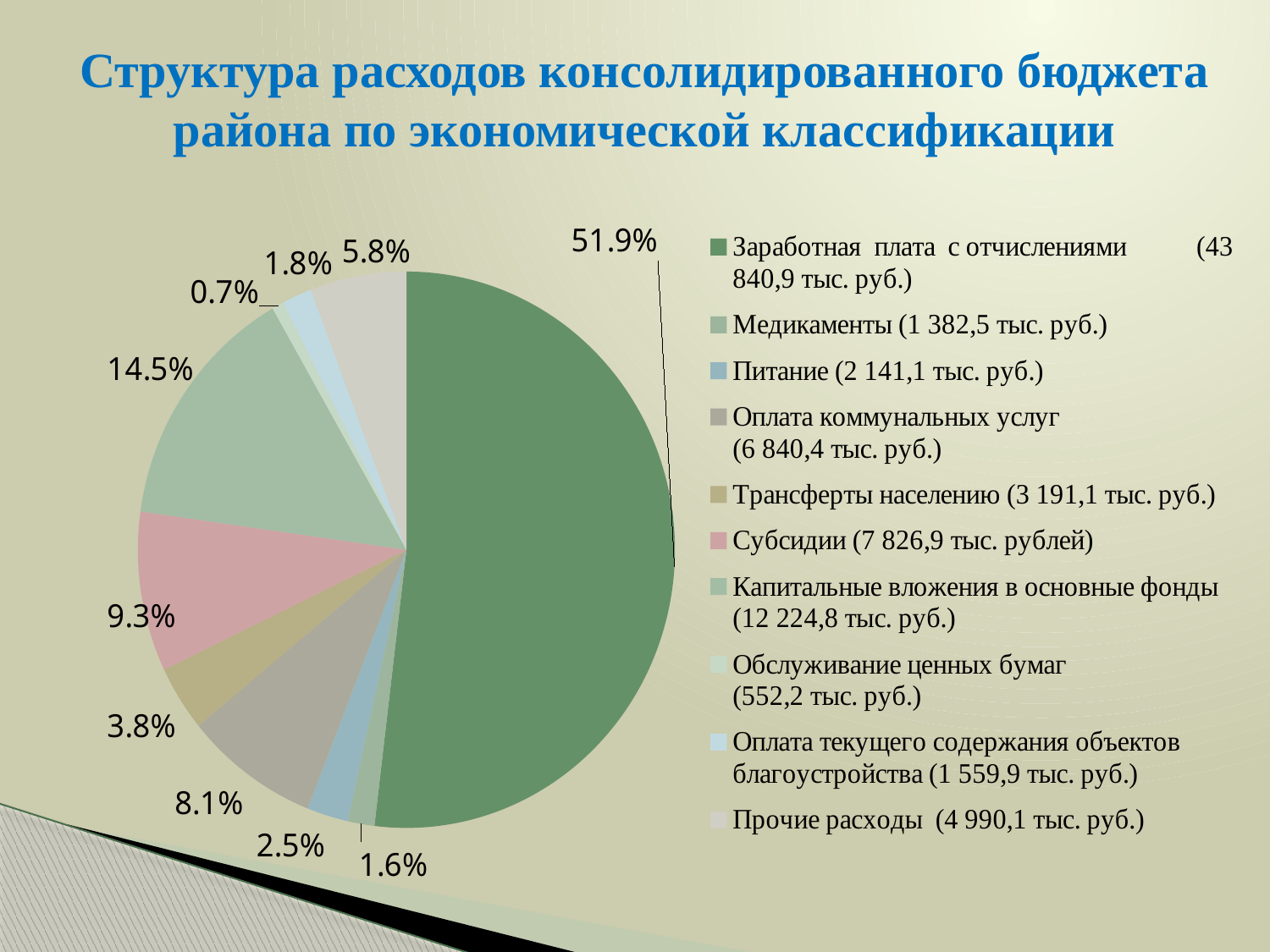
What share of the pie is labelled for Капитальные вложения в основные фонды? 14.5% What is the title of the slide? Структура расходов консолидированного бюджета района по экономической классификации Which is larger: the slice for Субсидии (9.3%) or the slice for Оплата коммунальных услуг (8.1%)? Субсидии How many entries does the legend list? 10 What percentage is shown for the smallest slice? 0.7% Which category has the smallest share of the pie? Обслуживание ценных бумаг What share of the pie does the largest slice (Заработная плата с отчислениями) take? 51.9% According to the legend, what amount is given for Прочие расходы? 4 990,1 тыс. руб. According to the legend, what amount is given for Медикаменты? 1 382,5 тыс. руб. What is the difference in percentage points between the 14.5% slice and the 9.3% slice? 5.2 How many slices does the pie chart have? 10 What kind of chart is shown on the slide? pie chart